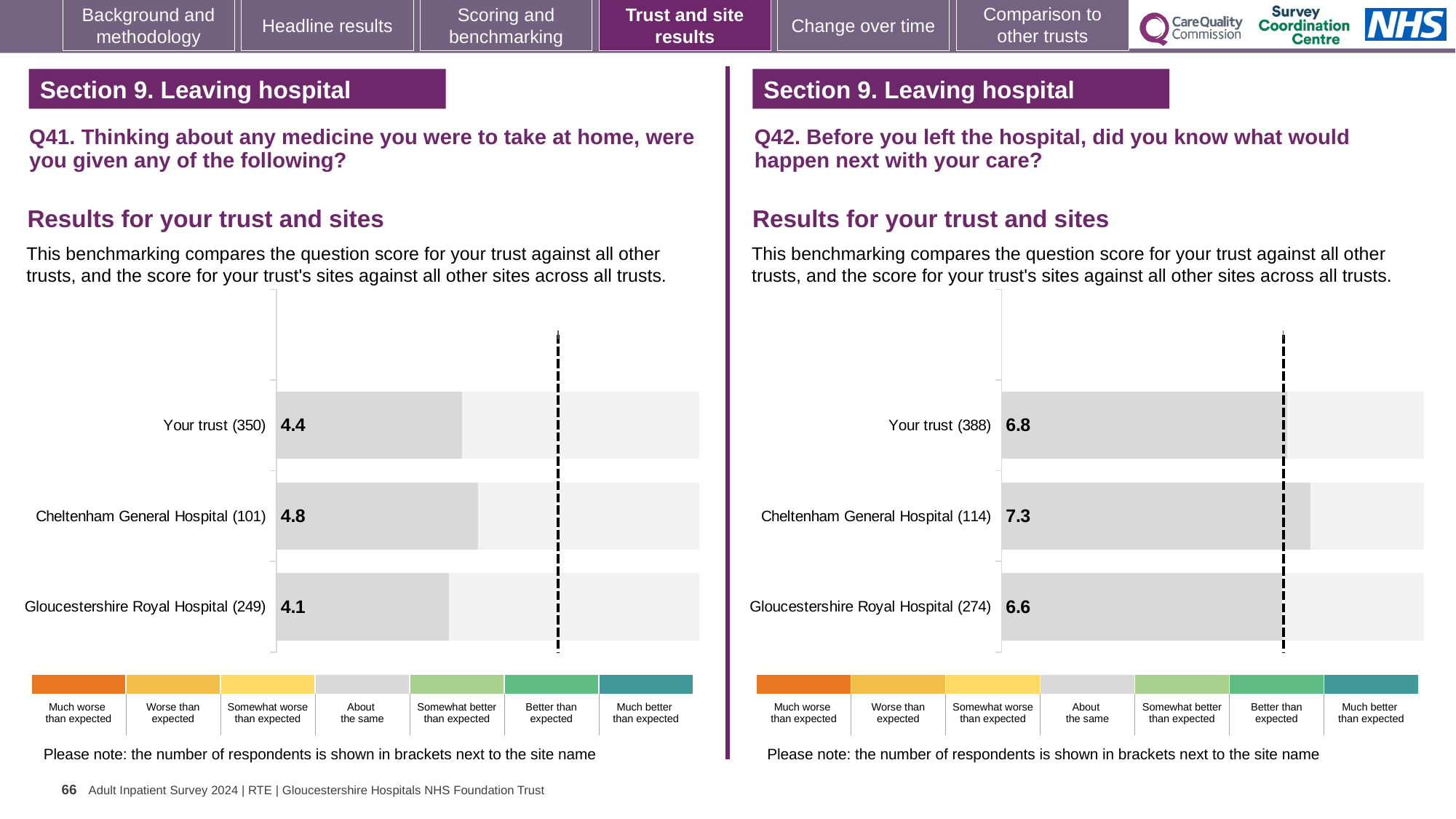
On the Q42 chart (right), what is the score for Gloucestershire Royal Hospital? 6.6 On the Q41 chart (left), what is the score for Your trust? 4.4 On the Q42 chart (right), what is the difference between the scores for Cheltenham General Hospital and Your trust? 0.5 How many categories does the colour key below the Q42 chart (right) list? 7 On the Q41 chart (left), what is the score for Cheltenham General Hospital? 4.8 What type of chart is used on the Q41 chart (left)? Bar chart On the Q42 chart (right), which site or trust has the highest score? Cheltenham General Hospital On the Q41 chart (left), which site or trust has the lowest score? Gloucestershire Royal Hospital How many bars are plotted on the Q42 chart (right)? 3 On the Q42 chart (right), is the score for Your trust or Cheltenham General Hospital larger? Cheltenham General Hospital On the Q41 chart (left), what is the difference between the scores for Cheltenham General Hospital and Gloucestershire Royal Hospital? 0.7 On the Q41 chart (left), how many respondents are shown in brackets for Your trust? 350